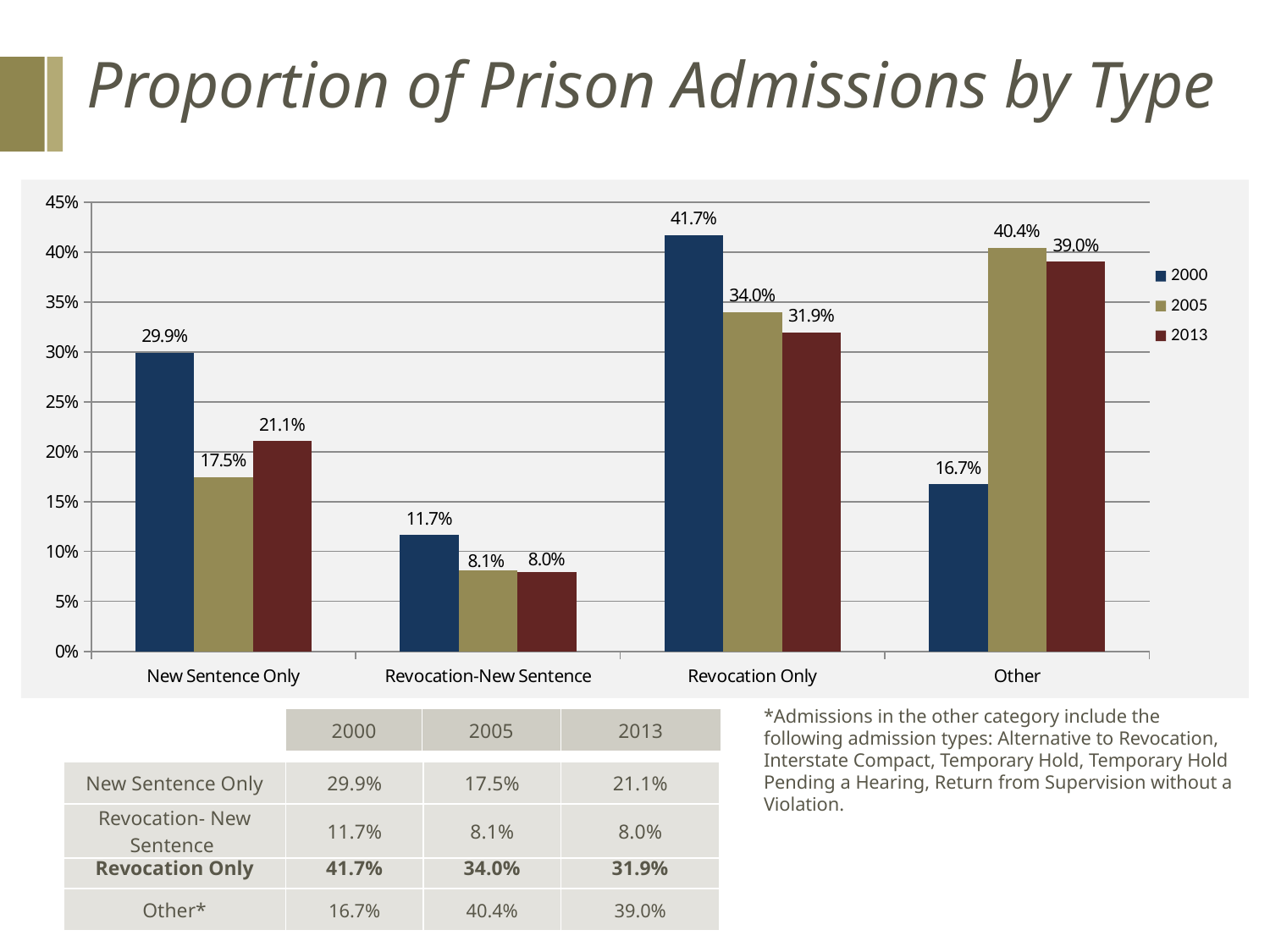
What is the title of the chart? Proportion of Prison Admissions by Type Which is larger for Other: the 2005 value or the 2013 value? 2005 What is the value for Revocation Only in 2000? 41.7% What is the value for Revocation-New Sentence in 2013? 8.0% What kind of chart is shown on the slide? Bar chart Which category has the highest value for the 2000 series? Revocation Only What is the value for Other in 2005? 40.4% Do the values for Revocation Only rise or fall from 2000 to 2013? Fall How many series does the legend list? 3 What is the difference between the 2000 and 2013 values for New Sentence Only? 8.8% Which category has the lowest value for the 2013 series? Revocation-New Sentence How many categories are shown on the x axis? 4